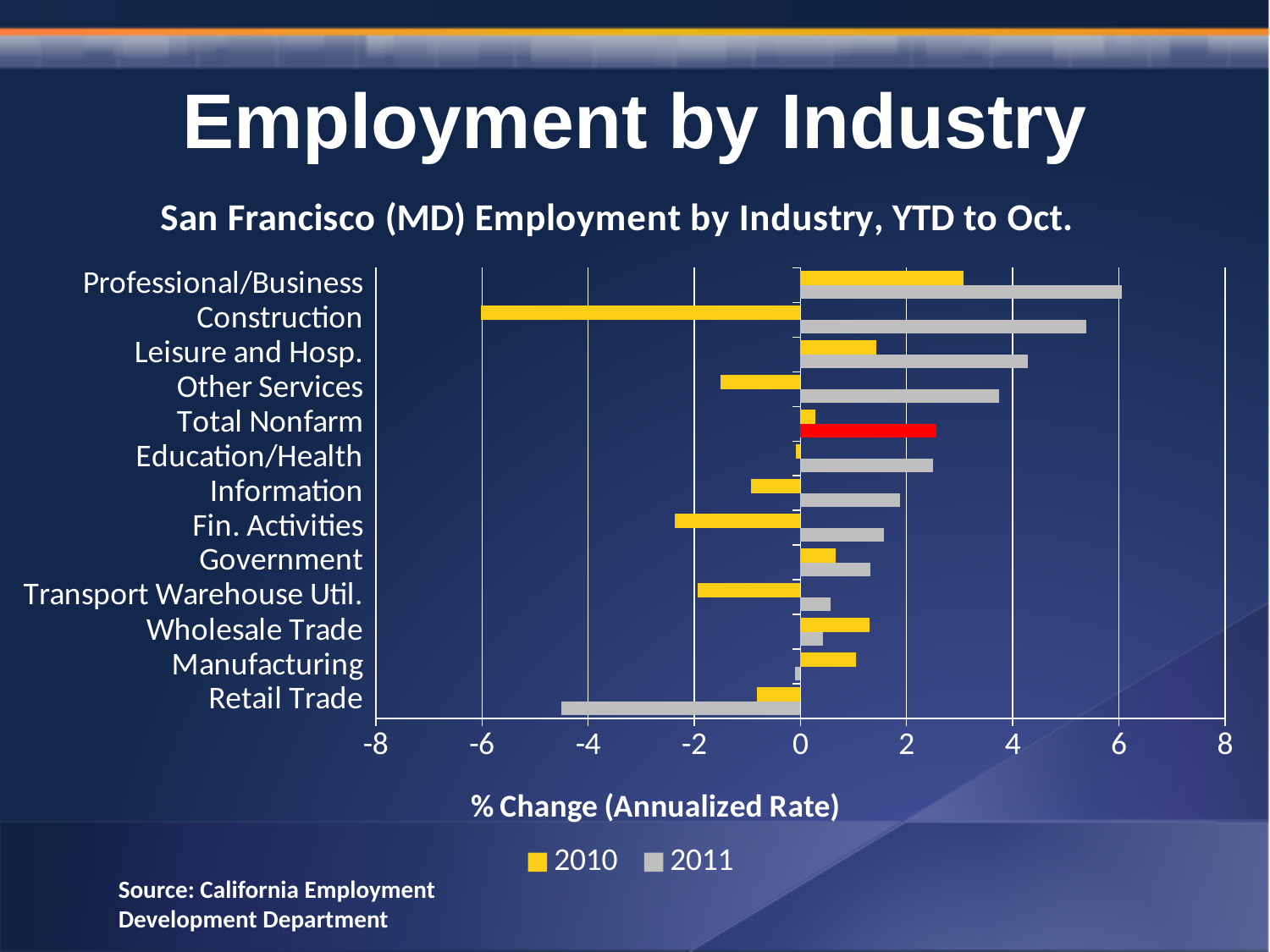
Which industry has the lowest 2011 value? Retail Trade What is the label of the x axis? % Change (Annualized Rate) Is the 2010 value for Construction greater or less than -4? less Which is larger, the 2010 value for Professional/Business or the 2010 value for Leisure and Hosp.? Professional/Business Which industry has the highest 2011 value? Professional/Business Is the 2011 value for Professional/Business greater or less than 4? greater Which is larger, the 2011 value for Construction or the 2011 value for Leisure and Hosp.? Construction How many series does the legend list? 2 How many industry categories are plotted on the chart? 13 Is the 2011 value for Retail Trade greater or less than -2? less What kind of chart is shown on the slide? bar chart Which industry has the lowest 2010 value? Construction